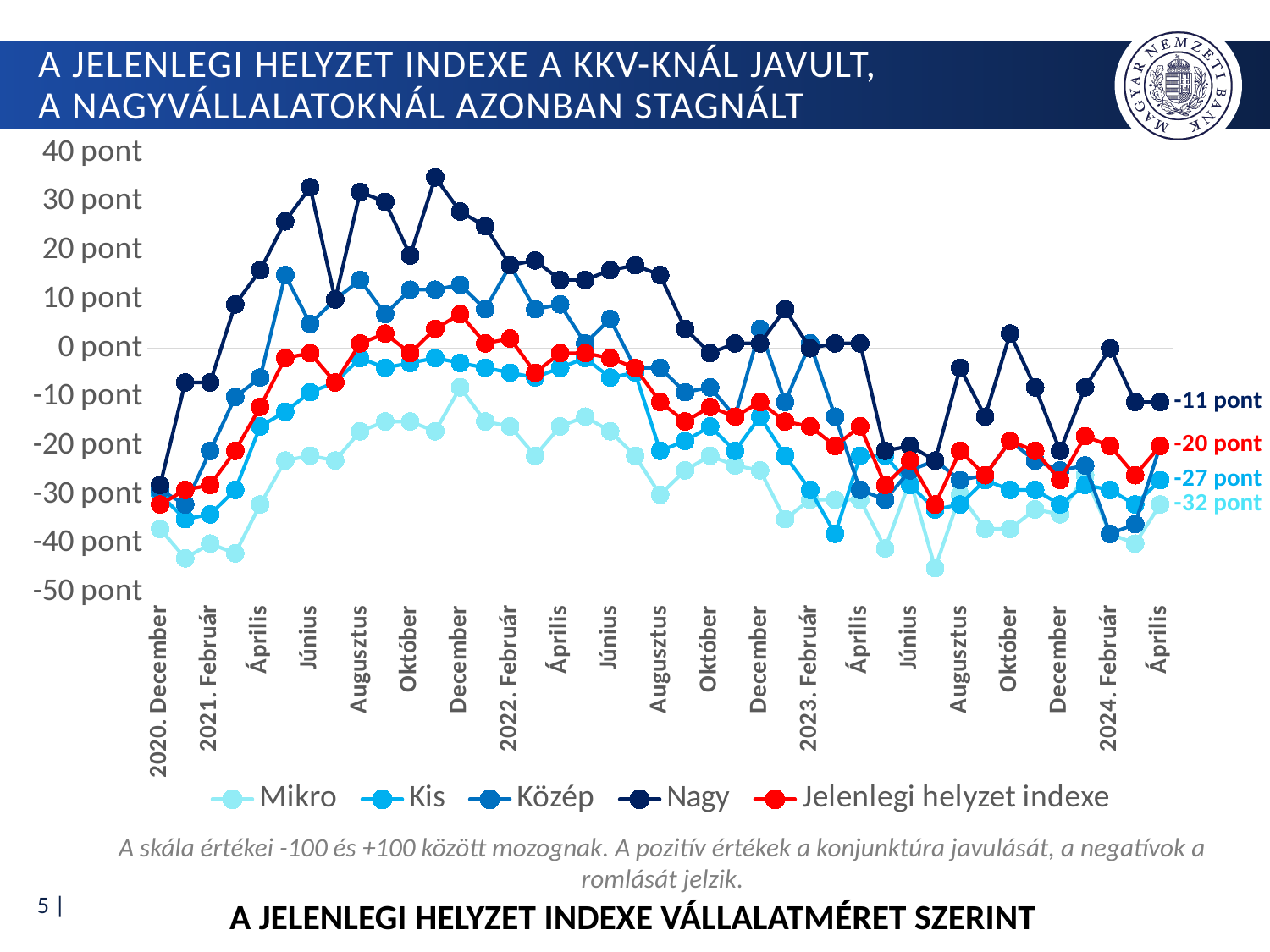
What is the value of the Közép series in 2024 Április? -20 pont Is the value for Mikro in 2020. December greater or less than -30 pont? less What is the value of the Mikro series in 2024 Április? -32 pont What is the title of the chart shown below the legend? A jelenlegi helyzet indexe vállalatméret szerint What is the value of the Jelenlegi helyzet indexe series in 2024 Április? -20 pont What is the value of the Nagy series in 2024 Április? -11 pont Which series has the lowest value in 2024 Április? Mikro What type of chart is shown on the slide? line chart How many series does the legend list? 5 Which series has the highest value in 2024 Április? Nagy What is the difference between the Nagy and Mikro values in 2024 Április? 21 pont In 2024 Április, which is higher: the Nagy series or the Jelenlegi helyzet indexe series? Nagy